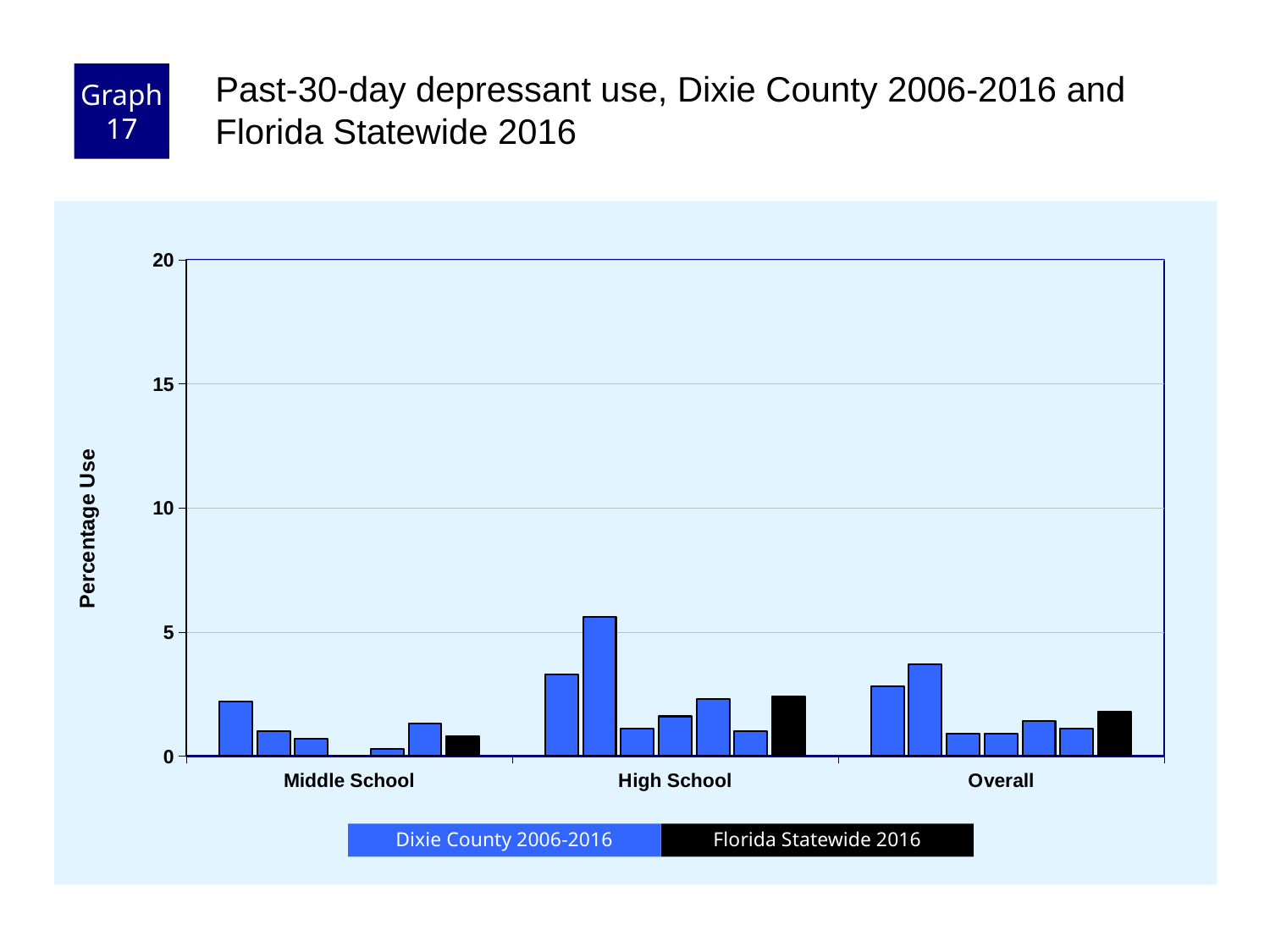
How many series does the legend list? 2 What colour are the Florida Statewide 2016 bars? black Is the Florida Statewide 2016 value for High School greater or less than 5? less What kind of chart is shown on the slide? bar chart Which category group contains the tallest bar on the chart? High School What is the label on the y axis? Percentage Use Is the Florida Statewide 2016 value for Middle School greater or less than 5? less Which is larger, the Florida Statewide 2016 value for High School or for Middle School? High School Which category has the lowest Florida Statewide 2016 bar? Middle School How many categories are shown on the x axis? 3 Is the tallest Dixie County 2006-2016 bar in the High School group greater or less than 5? greater Which is larger, the Florida Statewide 2016 value for High School or for Overall? High School